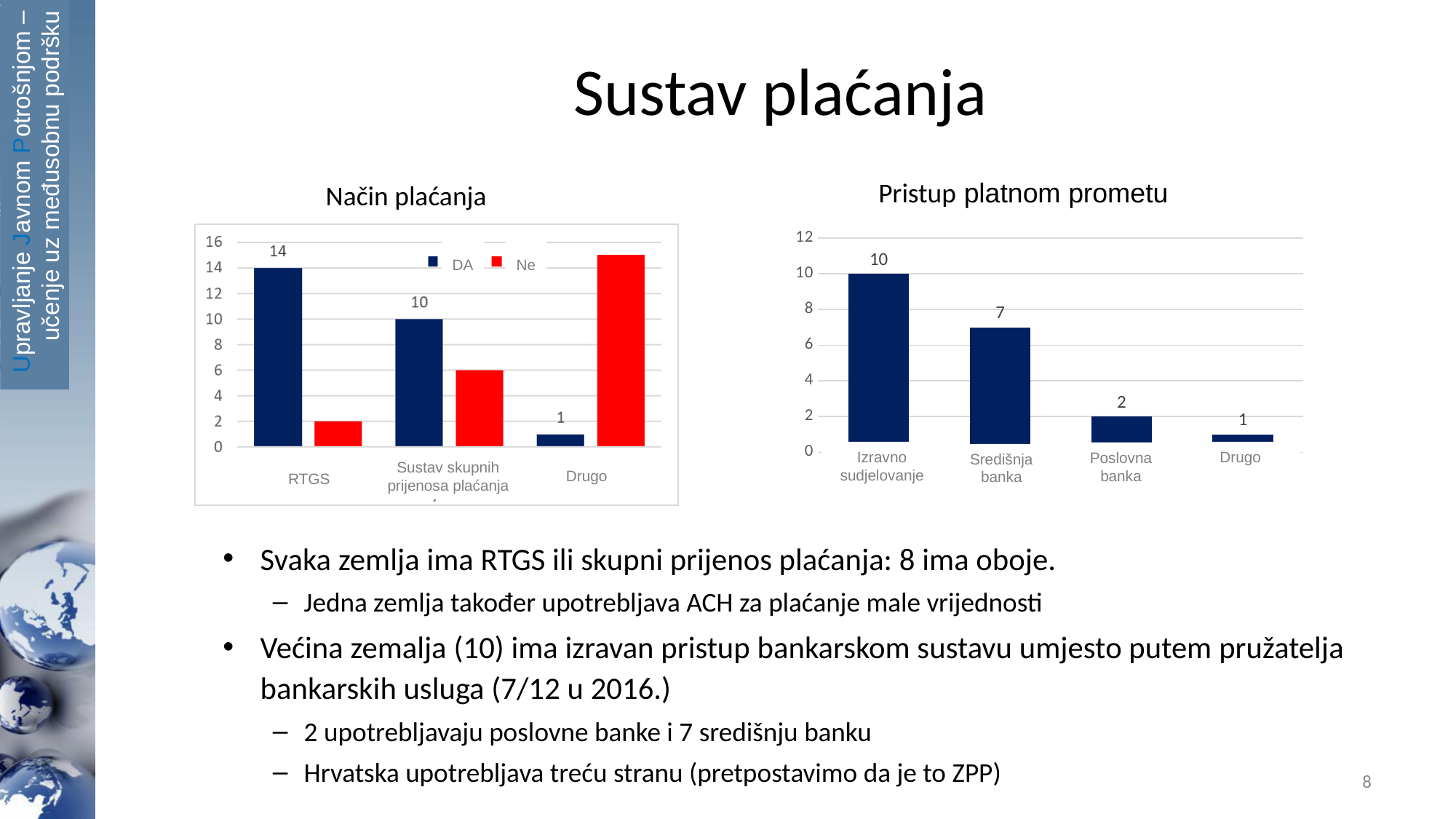
In the 'Način plaćanja' chart, how many series does the legend list? 2 In the 'Način plaćanja' chart, which colour represents the Ne series? Red In the 'Pristup platnom prometu' chart, which category has the lowest value? Drugo In the 'Način plaćanja' chart, what is the difference between the DA values for RTGS and Sustav skupnih prijenosa plaćanja? 4 In the 'Način plaćanja' chart, what is the DA value for Drugo? 1 In the 'Način plaćanja' chart, what is the DA value for Sustav skupnih prijenosa plaćanja? 10 In the 'Način plaćanja' chart, what is the DA value for RTGS? 14 What type of chart is 'Pristup platnom prometu'? Bar chart In the 'Pristup platnom prometu' chart, what is the value for Središnja banka? 7 In the 'Pristup platnom prometu' chart, how many categories are shown? 4 In the 'Način plaćanja' chart, is the Ne value for Drugo greater or less than 14? greater In the 'Pristup platnom prometu' chart, which category has the highest value? Izravno sudjelovanje